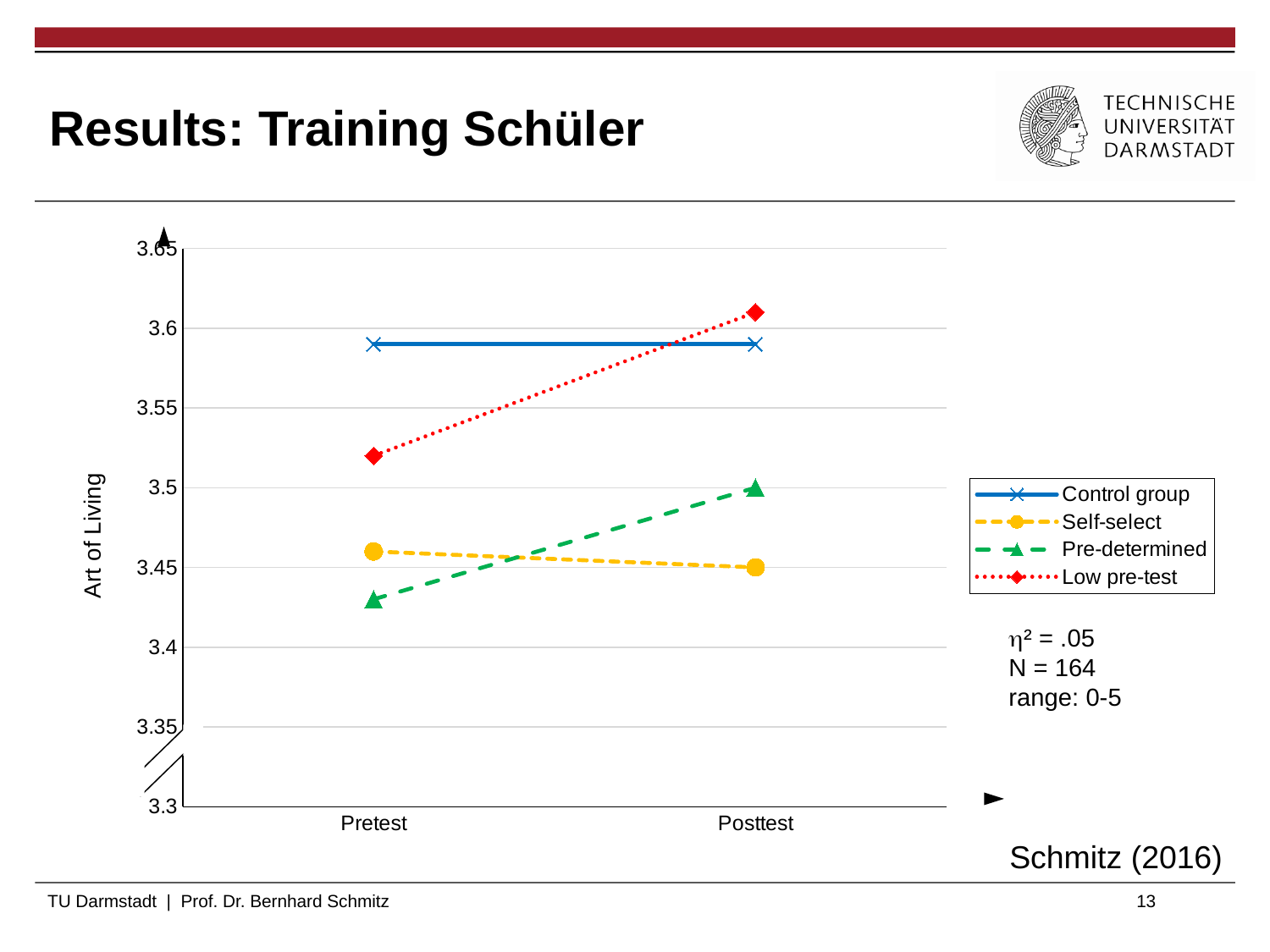
Does the Pre-determined series rise or fall from Pretest to Posttest? rise Is the value for Self-select at Posttest greater or less than 3.5? less How many series does the legend list? 4 Is the value for Pre-determined at Pretest greater or less than 3.45? less At Posttest, which is larger: Pre-determined or Self-select? Pre-determined Which series has the lowest value at Pretest? Pre-determined What is the label of the y axis? Art of Living At Pretest, which is larger: Control group or Low pre-test? Control group What kind of chart is shown on the slide? line chart Is the value for Control group at Pretest greater or less than 3.55? greater How many categories are shown on the x axis? 2